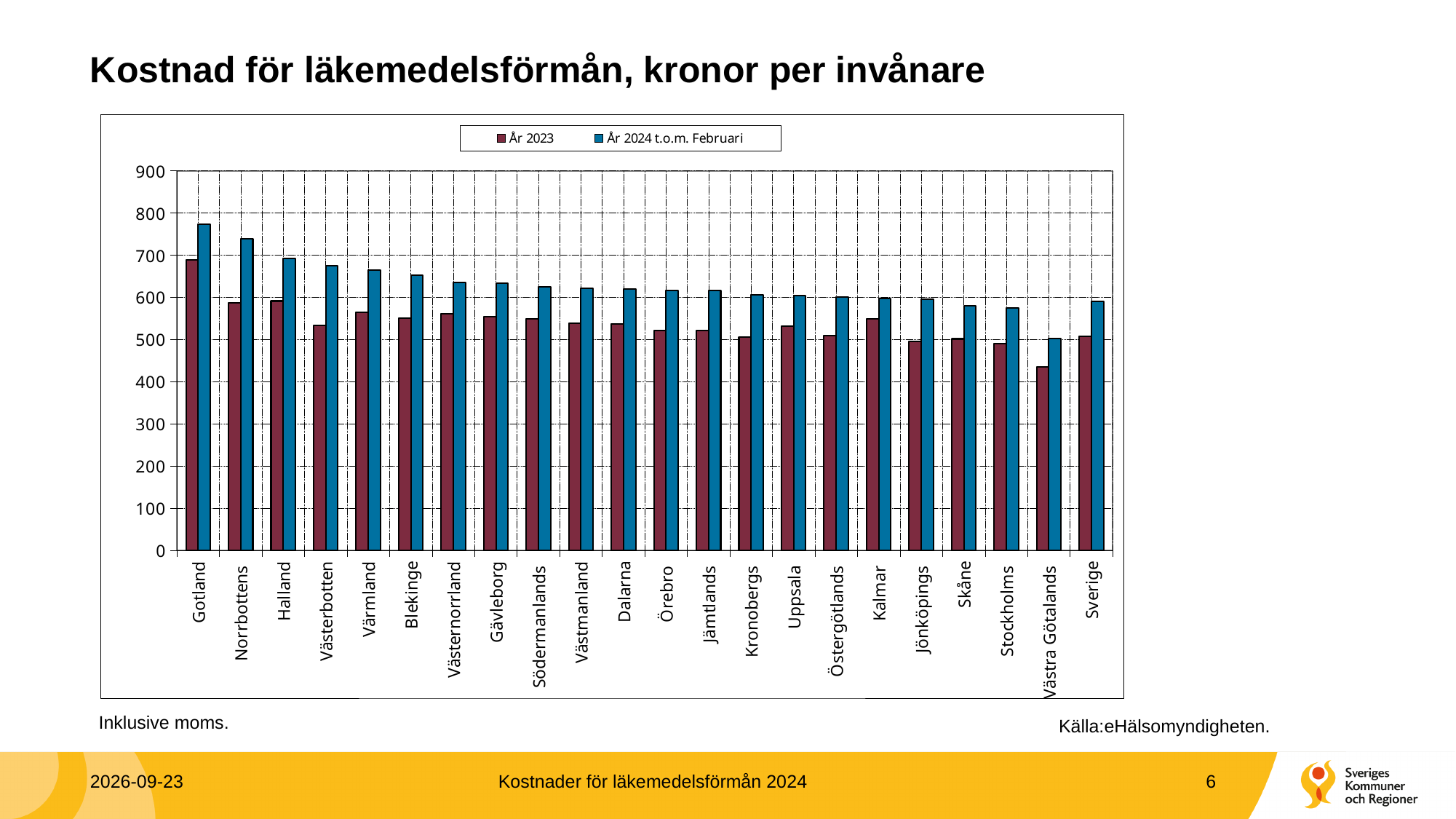
How many categories are shown along the x axis? 22 Which category has the lowest value for År 2024 t.o.m. Februari? Västra Götalands What are the two series named in the legend? År 2023 and År 2024 t.o.m. Februari Is the År 2024 t.o.m. Februari value for Skåne greater or less than 600? less Do the År 2024 t.o.m. Februari values generally rise or fall from left to right along the x axis? fall Is the År 2024 t.o.m. Februari value for Gotland greater or less than 700? greater What kind of chart is shown on the slide? bar chart Which category has the highest value for År 2024 t.o.m. Februari? Gotland Which category has the lowest value for År 2023? Västra Götalands Is the År 2023 value for Västra Götalands greater or less than 500? less Which is larger for År 2024 t.o.m. Februari: Gotland or Norrbottens? Gotland How many series does the legend list? 2